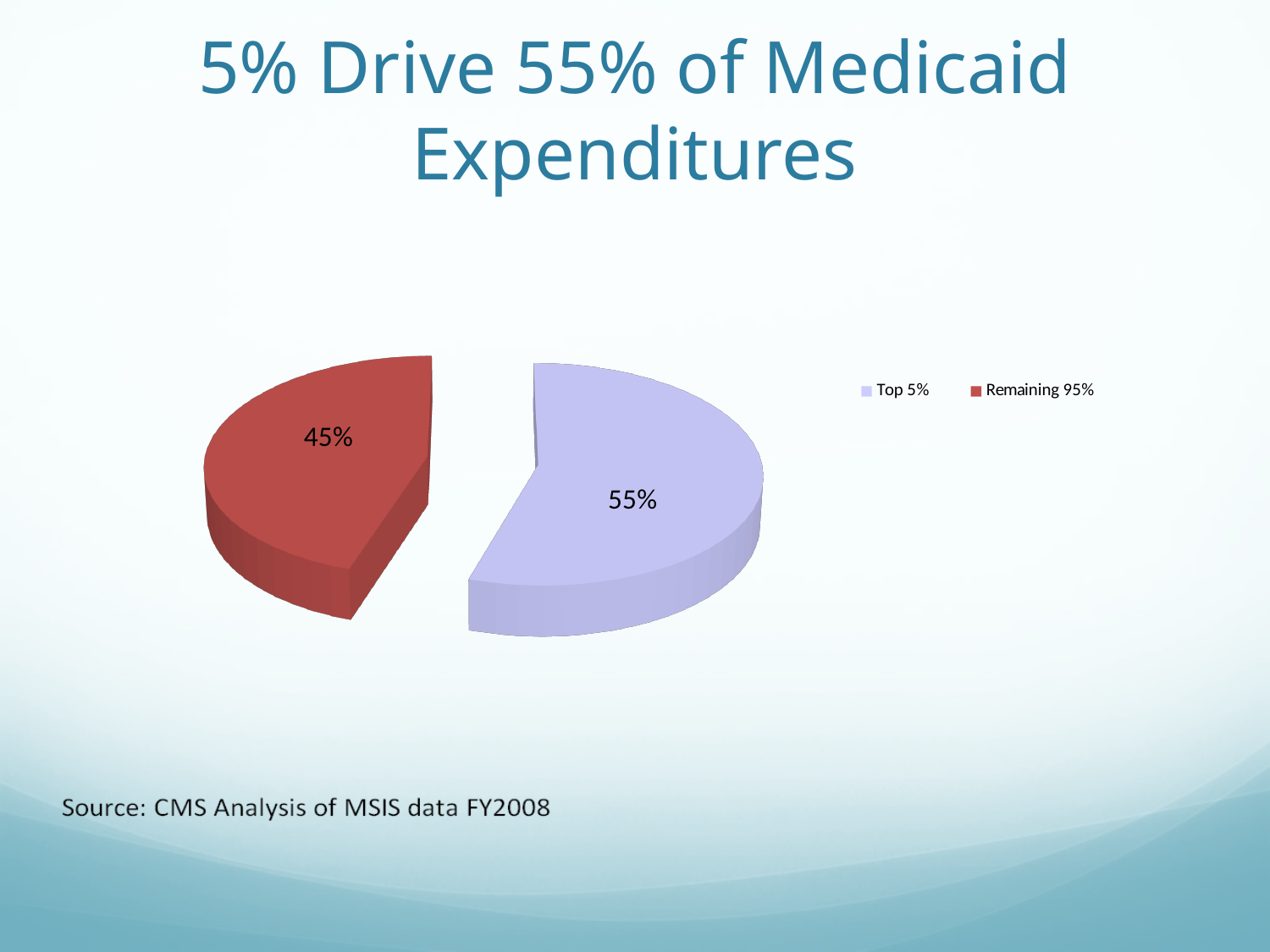
How many entries does the legend list? 2 How many slices does the pie chart have? 2 What is the difference in percentage points between the Top 5% slice and the Remaining 95% slice? 10 percentage points What colour is the Remaining 95% slice? red What colour is the Top 5% slice? light purple Which slice is larger, Top 5% or Remaining 95%? Top 5% Which slice is the smallest in the pie chart? Remaining 95% What kind of chart is shown on the slide? pie chart What share of Medicaid expenditures does the Remaining 95% slice represent? 45% Which slice is the largest in the pie chart? Top 5% Is the share for the Top 5% slice greater or less than 50%? greater What share of Medicaid expenditures does the Top 5% slice represent? 55%